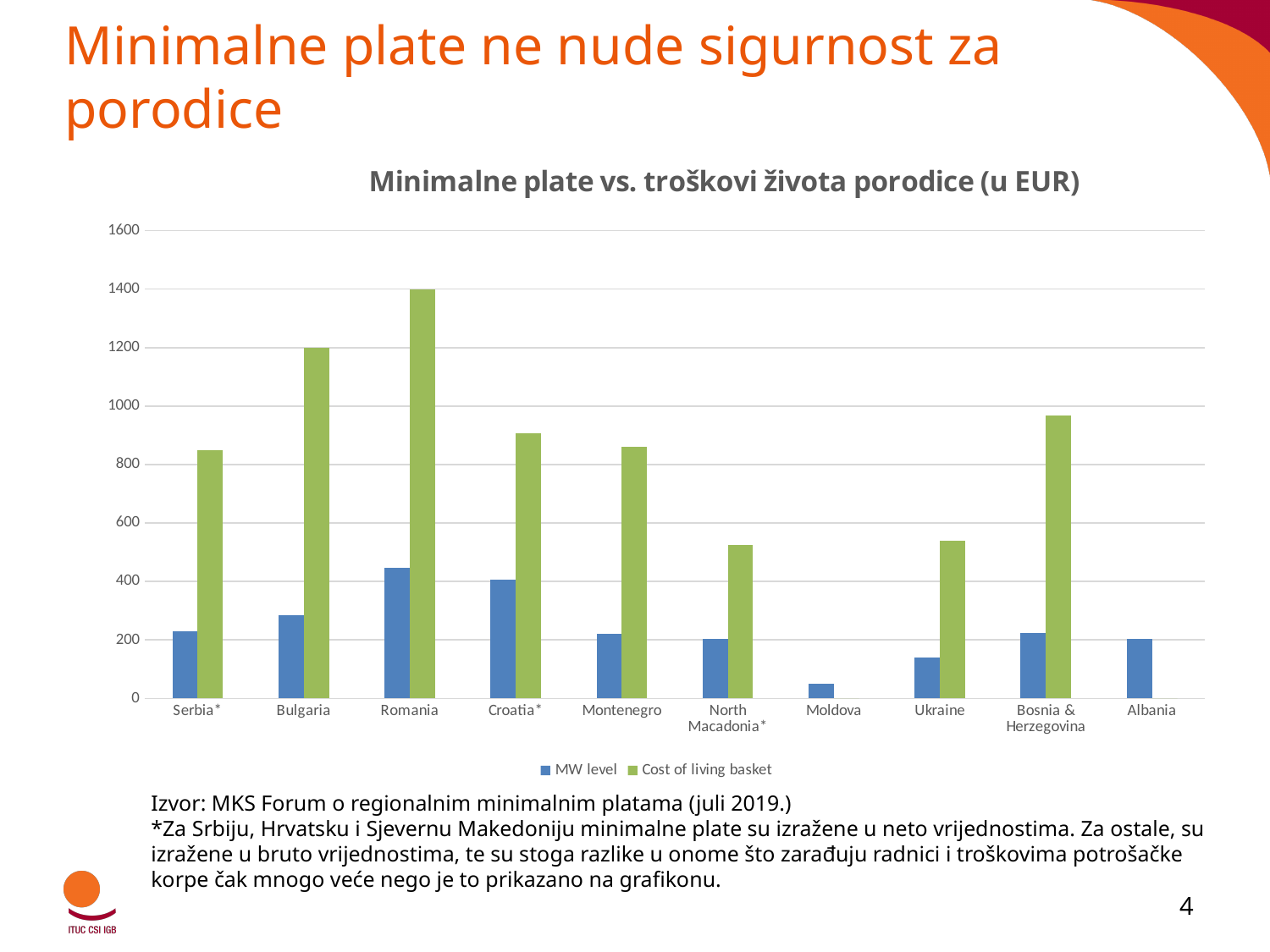
Is the Cost of living basket value for Serbia* greater or less than 800? greater What is the title of the chart? Minimalne plate vs. troškovi života porodice (u EUR) Which is larger: the Cost of living basket for Bulgaria or for Croatia*? Bulgaria Is the Cost of living basket value for Bulgaria greater or less than 1000? greater Is the MW level for Moldova greater or less than 100? less How many countries are shown on the x axis? 10 Which country has the highest MW level? Romania Which country has the highest Cost of living basket value? Romania How many series does the legend list? 2 What type of chart is shown on the slide? bar chart Which country has the lowest MW level? Moldova